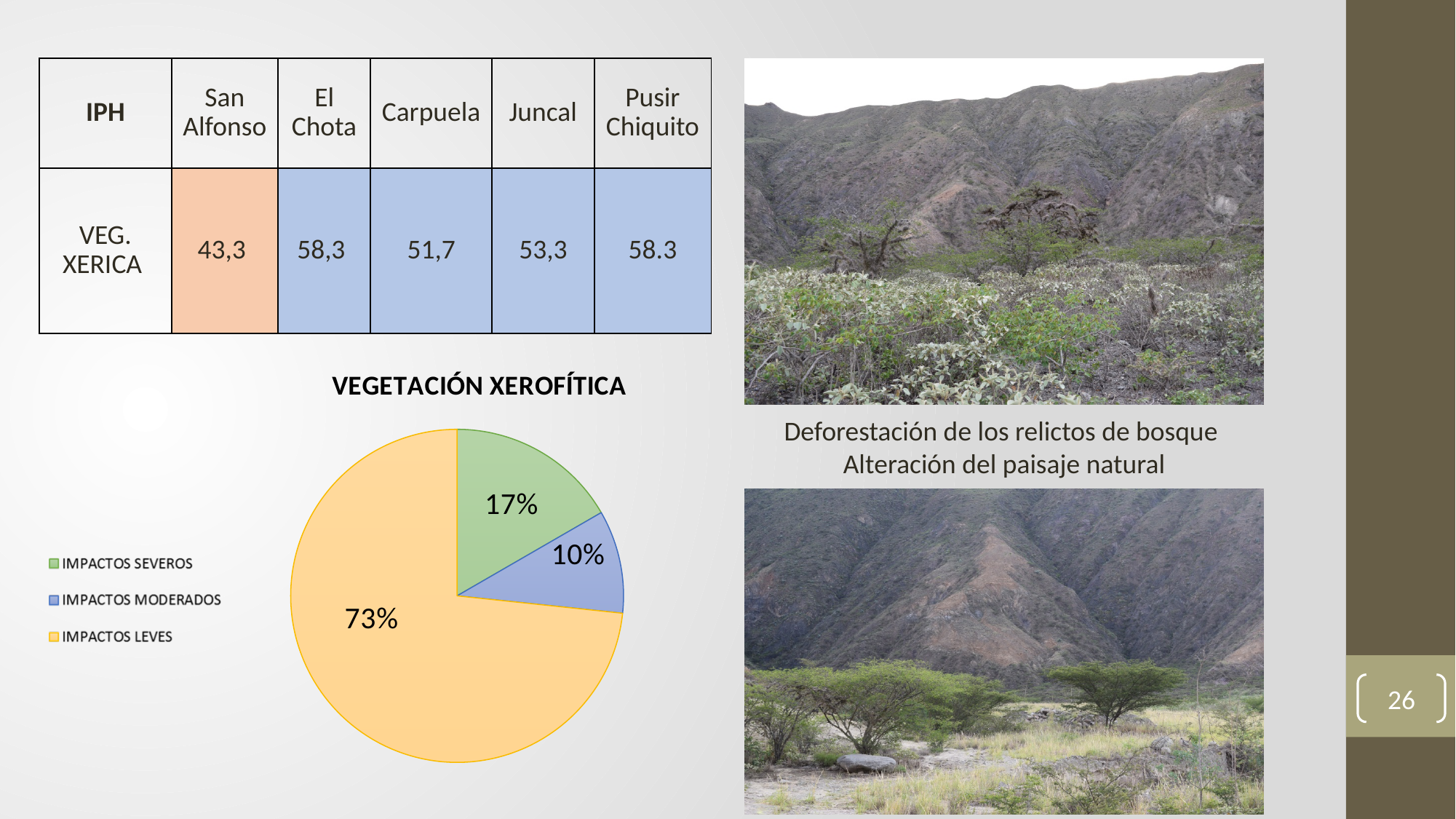
What colour is the IMPACTOS LEVES slice in the pie chart? yellow What is the title of the pie chart? VEGETACIÓN XEROFÍTICA What share of the pie chart does IMPACTOS MODERADOS represent? 10% What is the combined share of IMPACTOS SEVEROS and IMPACTOS MODERADOS in the pie chart? 27% What share of the pie chart does IMPACTOS LEVES represent? 73% What is the difference in percentage points between IMPACTOS LEVES and IMPACTOS SEVEROS in the pie chart? 56 What share of the pie chart does IMPACTOS SEVEROS represent? 17% Which category has the largest slice in the pie chart? IMPACTOS LEVES Which category has the smallest slice in the pie chart? IMPACTOS MODERADOS Which is larger in the pie chart, IMPACTOS SEVEROS or IMPACTOS MODERADOS? IMPACTOS SEVEROS What kind of chart is shown under the title VEGETACIÓN XEROFÍTICA? pie chart How many slices does the pie chart have? 3